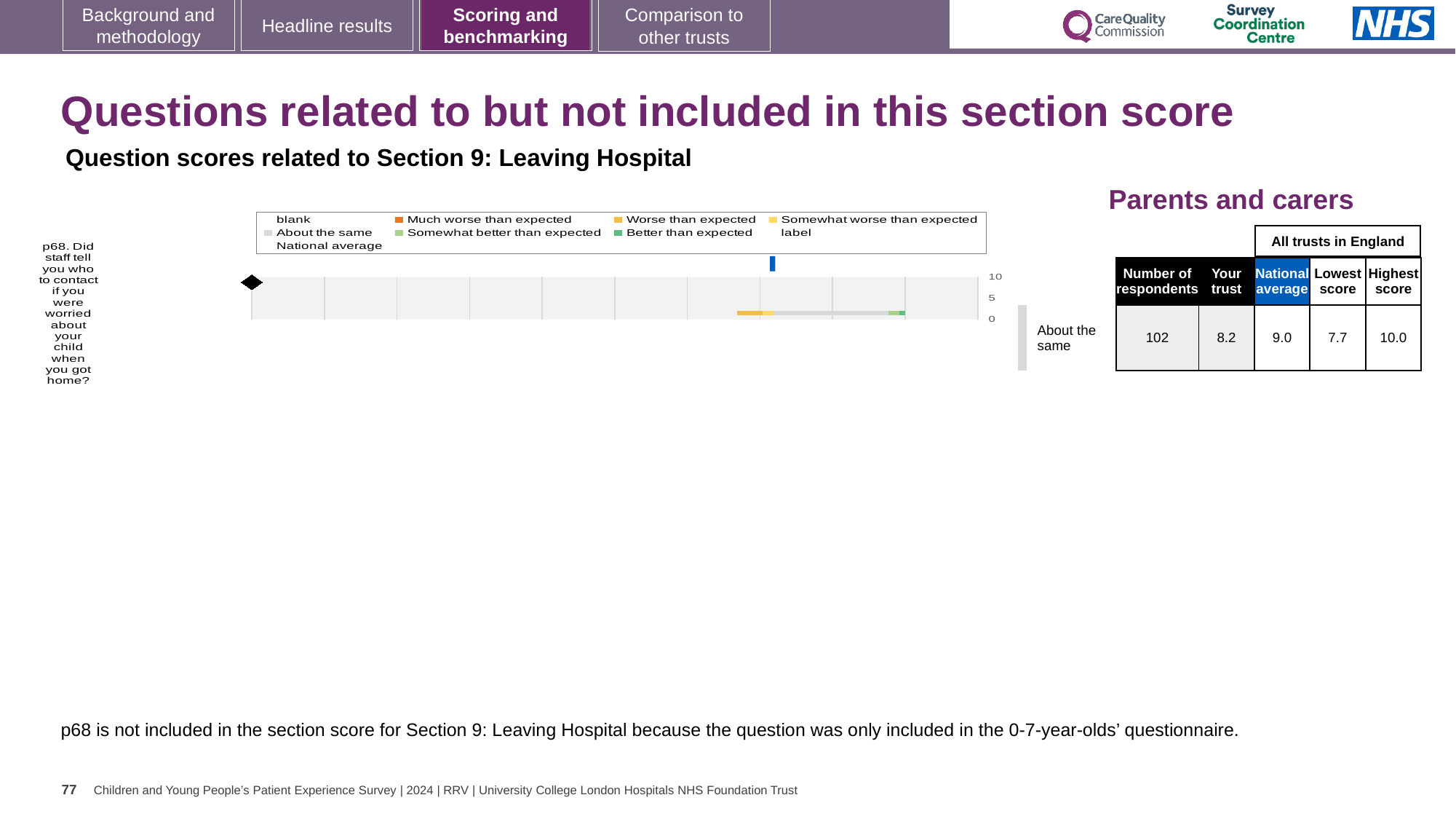
According to the table beside the chart, what is the lowest score among all trusts in England for question p68? 7.7 What is the question number of the item plotted in the chart? p68 What kind of chart is used to show the benchmarking result for question p68? bar chart How many respondents answered question p68, according to the table beside the chart? 102 Is the 'Your trust' score for p68 larger or smaller than the national average? smaller What is the highest tick value shown on the chart's score axis? 10 What benchmarking category label is shown to the right of the chart for question p68? About the same How many questions (categories) are plotted in the chart? 1 According to the table beside the chart, what is the 'Your trust' score for question p68? 8.2 According to the table beside the chart, what is the national average score for question p68? 9.0 What is the difference between the highest score and the lowest score for p68 in the table beside the chart? 2.3 According to the table beside the chart, what is the highest score among all trusts in England for question p68? 10.0